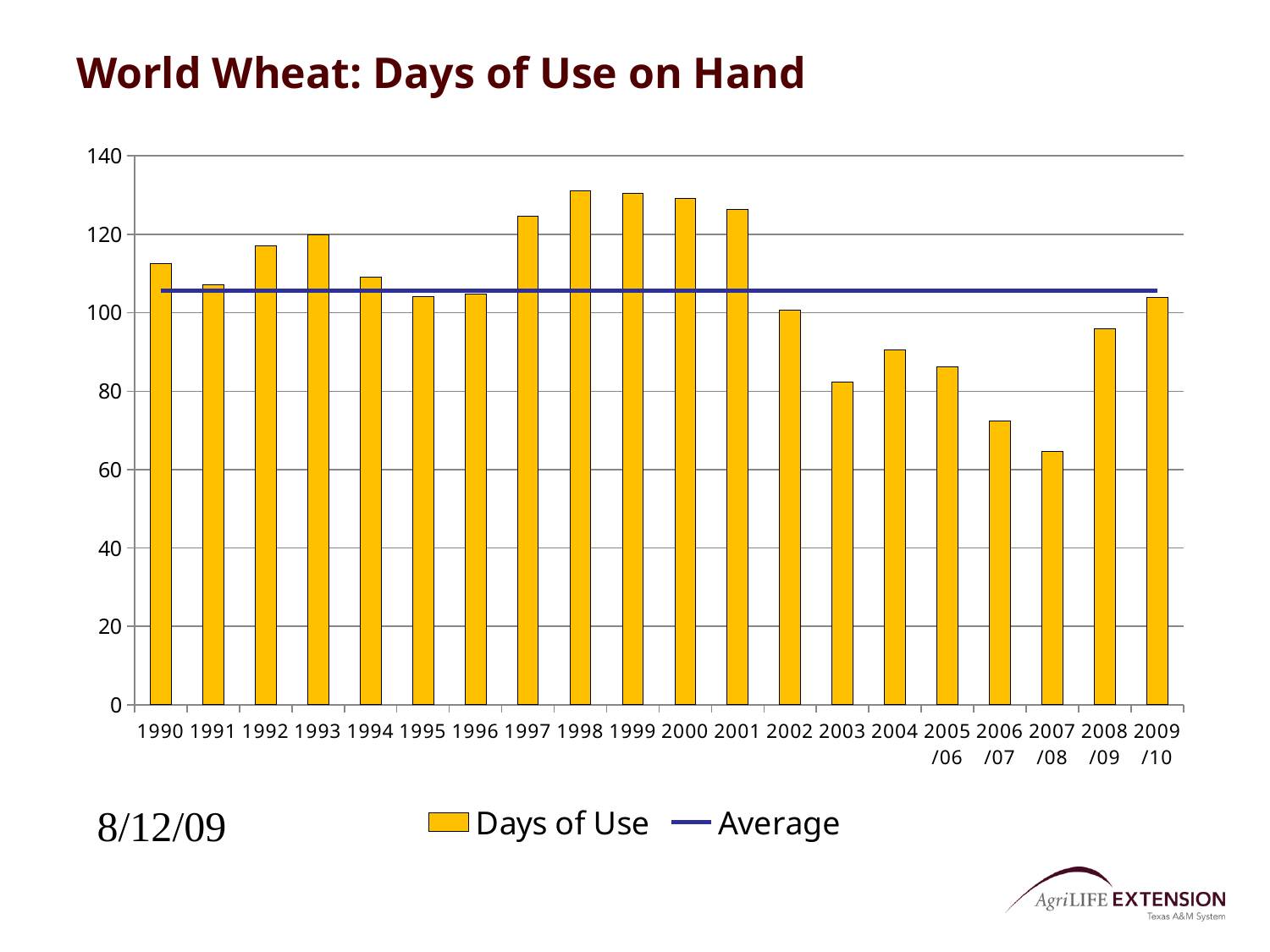
What kind of chart is shown on the slide? combination bar and line chart Which has the larger Days of Use value, 2003 or 2004? 2004 Is the Days of Use value for 2003 greater or less than 100? less How many years (categories) are shown on the x axis? 20 Which year has the lowest Days of Use? 2007/08 Which has the larger Days of Use value, 1998 or 2007/08? 1998 Do the Days of Use values rise or fall from 2001 to 2007/08? fall What is the title of the chart? World Wheat: Days of Use on Hand Is the Days of Use value for 2007/08 greater or less than 80? less How many series does the legend list? 2 Is the Days of Use value for 1998 greater or less than 120? greater